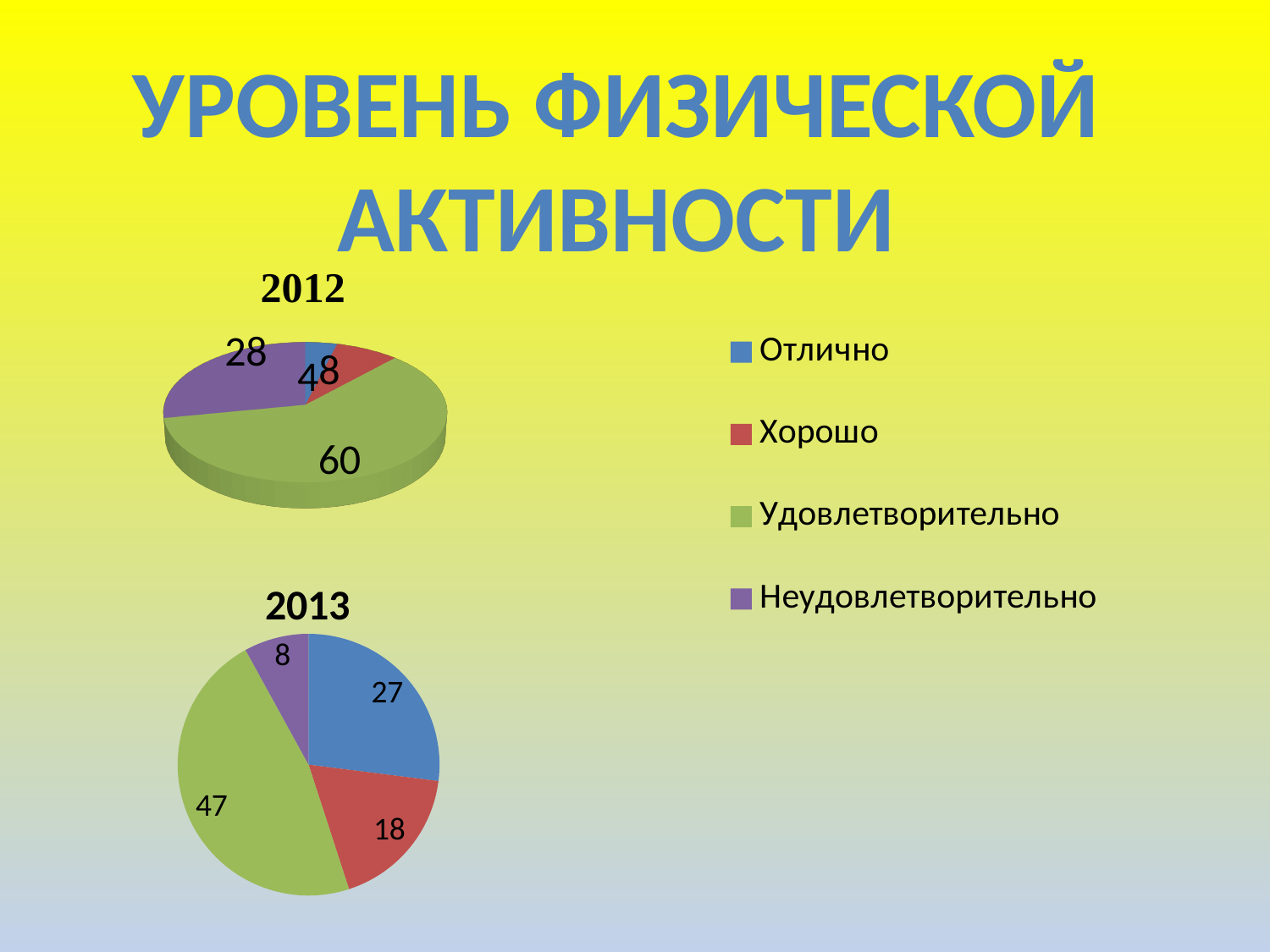
In the 2013 chart, what is the difference between the values for Удовлетворительно and Отлично? 20 How many categories does the legend list? 4 What type of chart is the 2012 chart? pie chart In the 2013 chart, which category has the smallest slice? Неудовлетворительно In the 2013 chart, which category has the largest slice? Удовлетворительно In the 2012 chart, which is larger: Удовлетворительно or Неудовлетворительно? Удовлетворительно Which colour represents Хорошо in the legend? red In the 2013 chart, what is the value for Отлично? 27 In the 2012 chart, what is the value for Удовлетворительно? 60 In the 2013 chart, what is the value for Неудовлетворительно? 8 In the 2013 chart, what is the value for Хорошо? 18 In the 2012 chart, what is the value for Неудовлетворительно? 28